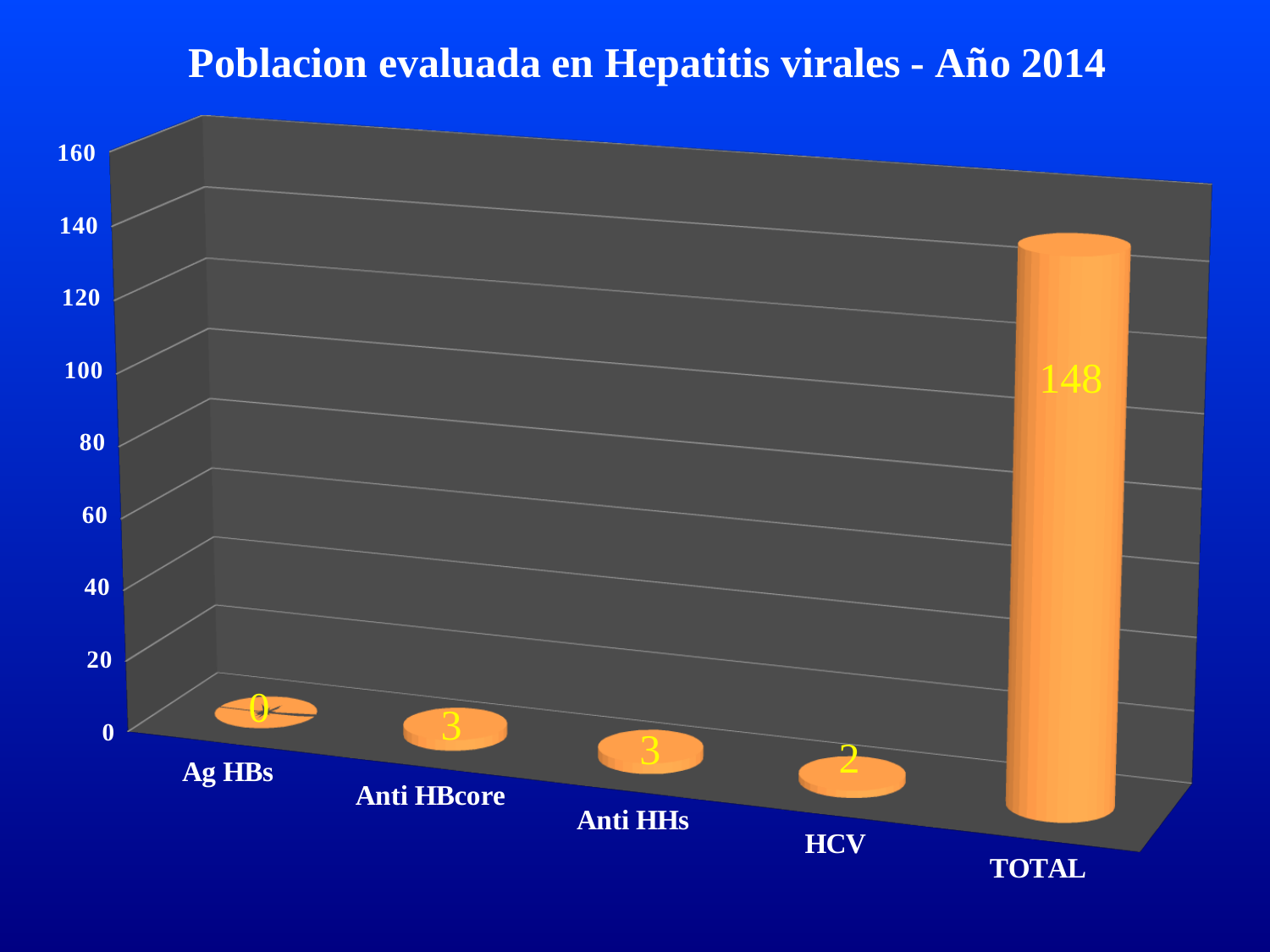
Is the value for TOTAL greater or less than 140? greater What is the value for HCV? 2 What is the value for Ag HBs? 0 How many categories are shown on the x axis? 5 Which category has the highest value? TOTAL What is the difference between the values for TOTAL and Anti HHs? 145 What is the value for TOTAL? 148 What is the value for Anti HBcore? 3 Which category has the lowest value? Ag HBs What is the title of the chart? Poblacion evaluada en Hepatitis virales - Año 2014 Which is larger, the value for Anti HBcore or the value for HCV? Anti HBcore What kind of chart is shown on the slide? bar chart